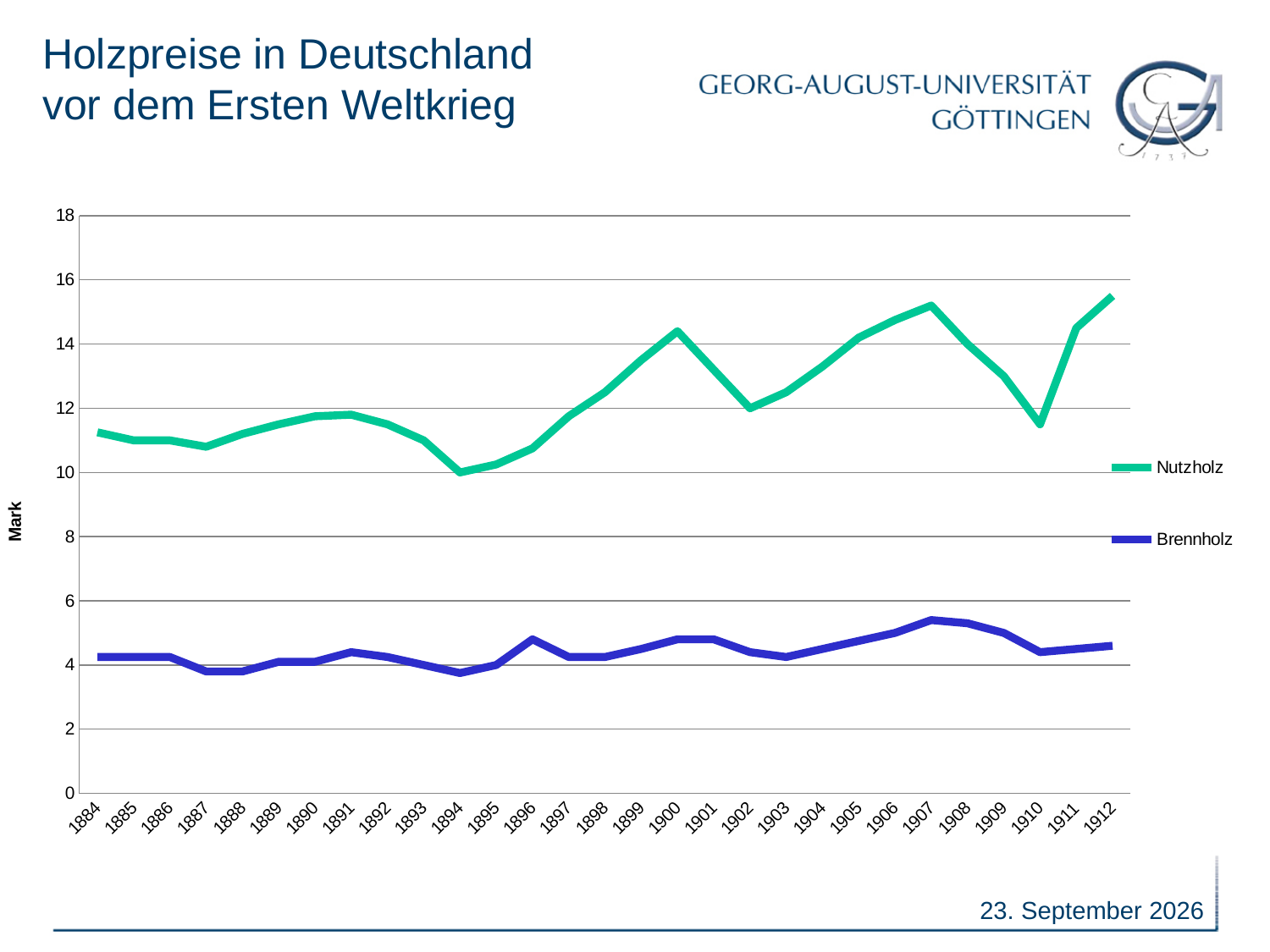
Which year has the lowest Nutzholz value? 1894 How many series does the legend list? 2 How many years are plotted along the x axis? 29 What is the label on the y axis? Mark What kind of chart is shown on the slide? line chart Is the Brennholz value for 1884 greater or less than 6? less Is the Nutzholz value larger in 1900 or in 1902? 1900 Does the Nutzholz line rise or fall from 1894 to 1900? rise Is the Nutzholz value for 1894 greater or less than 12? less Which year has the highest Brennholz value? 1907 In 1900, which series has the larger value, Nutzholz or Brennholz? Nutzholz Is the Nutzholz value for 1907 greater or less than 14? greater